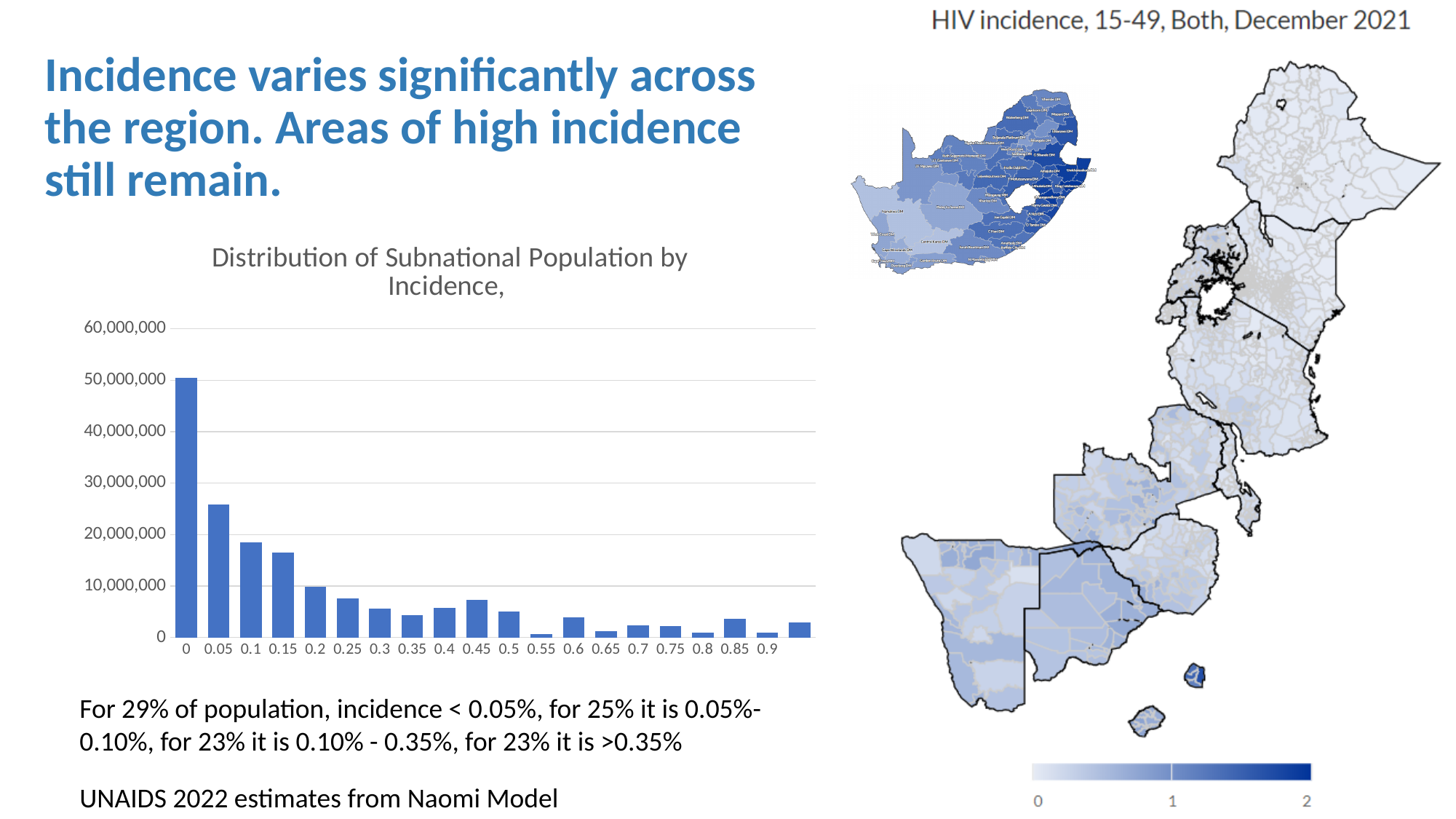
In the 'Distribution of Subnational Population by Incidence' chart, which has the larger population: the 0.05 category or the 0.1 category? 0.05 What is the highest value shown on the colour scale legend of the map on the right? 2 In the 'Distribution of Subnational Population by Incidence' chart, which incidence category has the highest population? 0 In the 'Distribution of Subnational Population by Incidence' chart, which has the larger population: the 0.35 category or the 0.45 category? 0.45 What is the title of the map on the right side of the slide? HIV incidence, 15-49, Both, December 2021 What kind of chart is the 'Distribution of Subnational Population by Incidence' chart? bar chart In the 'Distribution of Subnational Population by Incidence' chart, is the value for the 0 category greater or less than 40,000,000? greater In the 'Distribution of Subnational Population by Incidence' chart, is the value for the 0.15 category greater or less than 10,000,000? greater In the 'Distribution of Subnational Population by Incidence' chart, is the value for the 0.05 category greater or less than 20,000,000? greater In the 'Distribution of Subnational Population by Incidence' chart, do the values generally rise or fall as incidence increases along the x axis? fall